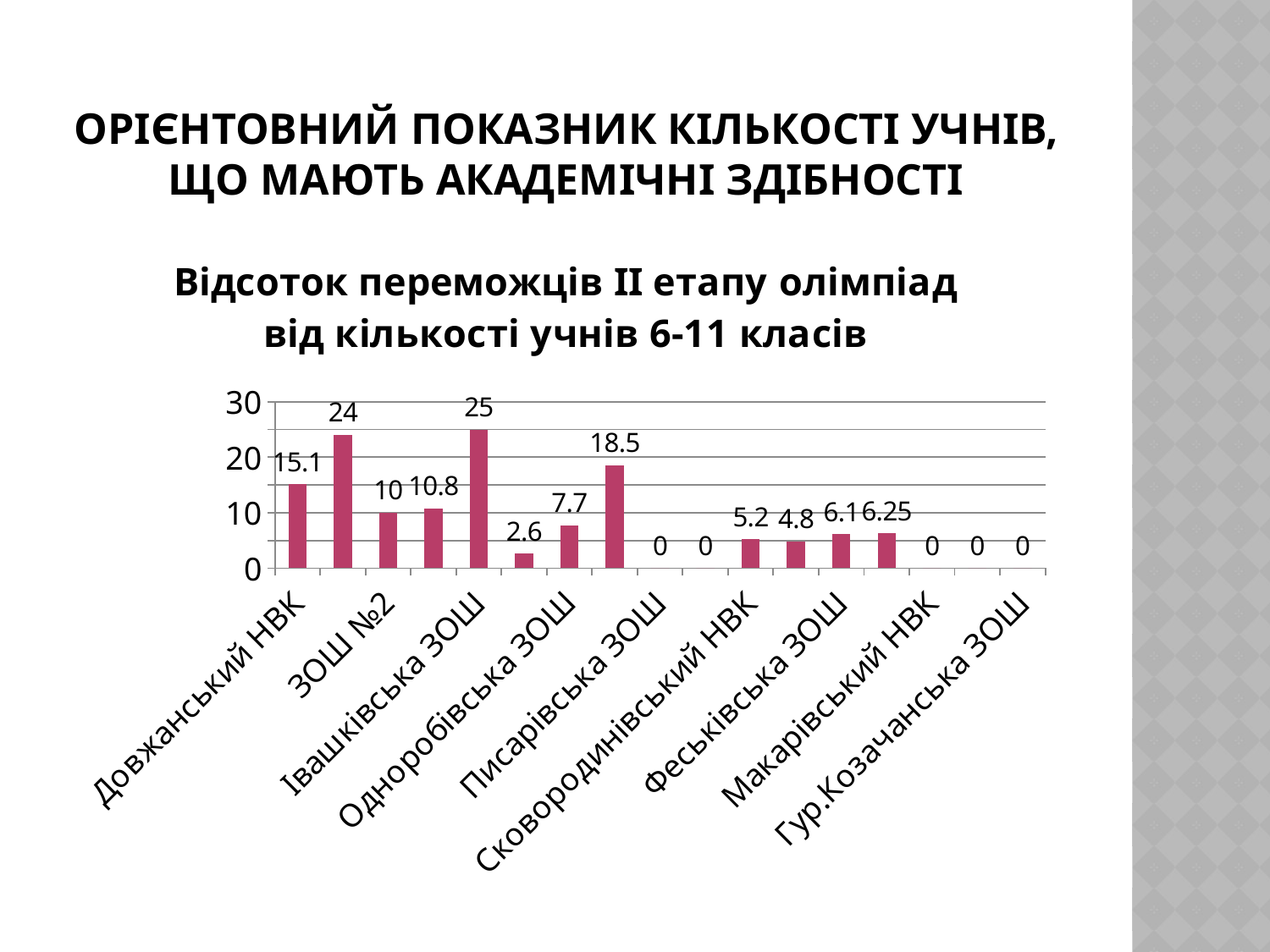
What is the title of the chart? Відсоток переможців ІІ етапу олімпіад від кількості учнів 6-11 класів How many bars are plotted in the chart? 17 What is the difference between the values for Івашківська ЗОШ and Довжанський НВК? 9.9 What is the value for Сковородинівський НВК? 5.2 Is the value for Івашківська ЗОШ greater or less than 20? greater What is the value for Довжанський НВК? 15.1 What kind of chart is shown on the slide? bar chart Which is larger, the value for Довжанський НВК or the value for ЗОШ №2? Довжанський НВК What is the value for Івашківська ЗОШ? 25 What is the value for Одноробівська ЗОШ? 7.7 What is the value for ЗОШ №2? 10 Which category has the highest value? Івашківська ЗОШ